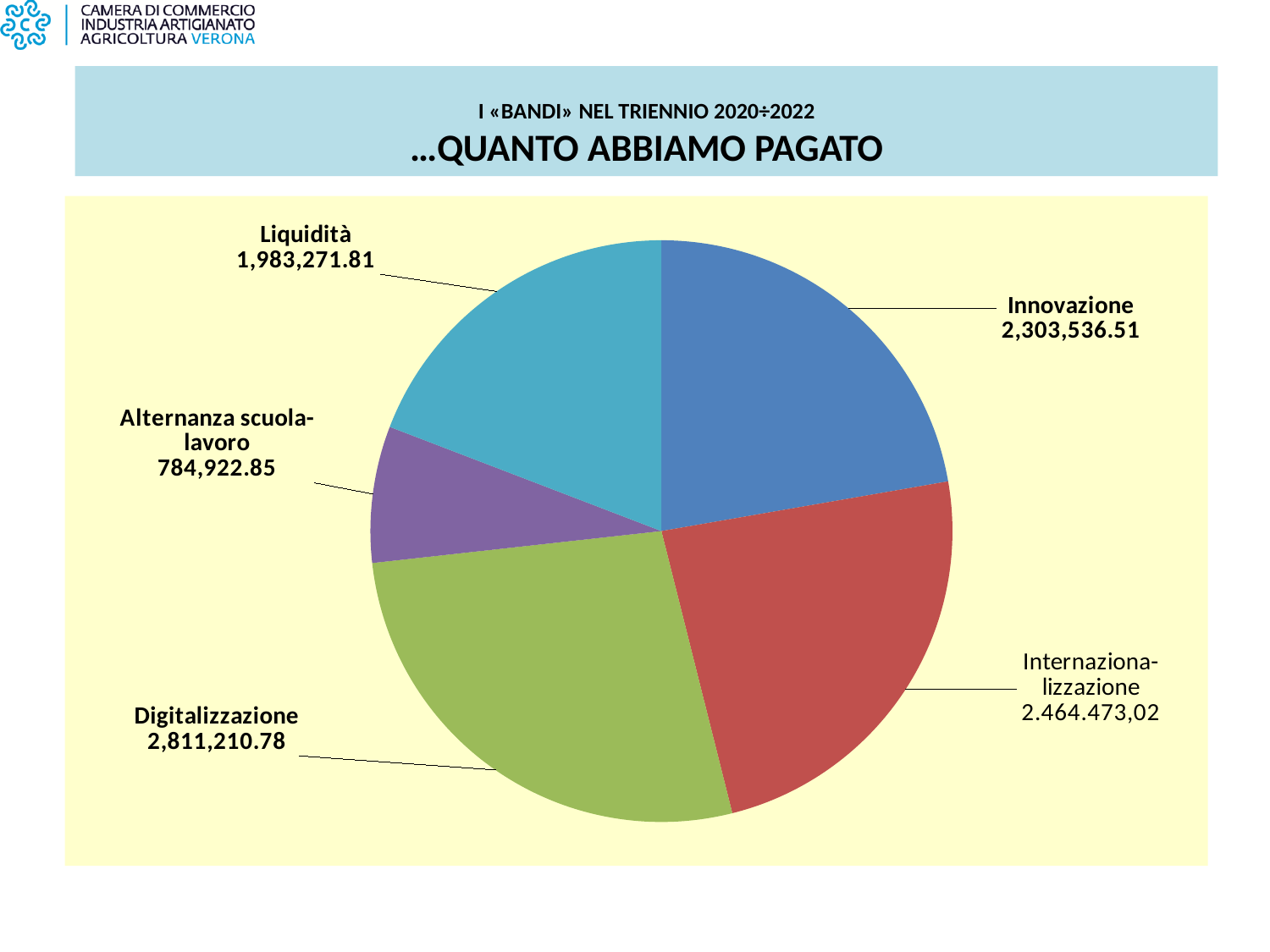
What value is shown for Internazionalizzazione in the pie chart? 2.464.473,02 What value is shown for Digitalizzazione in the pie chart? 2,811,210.78 What is the difference between the values for Digitalizzazione and Innovazione? 507,674.27 What value is shown for Innovazione in the pie chart? 2,303,536.51 Which category has the smallest slice in the pie chart? Alternanza scuola-lavoro What is the difference between the values for Liquidità and Alternanza scuola-lavoro? 1,198,348.96 Which is larger, the value for Internazionalizzazione or the value for Innovazione? Internazionalizzazione Which category has the largest slice in the pie chart? Digitalizzazione What value is shown for Alternanza scuola-lavoro in the pie chart? 784,922.85 What kind of chart is shown on the slide? Pie chart What value is shown for Liquidità in the pie chart? 1,983,271.81 How many categories are shown in the pie chart? 5